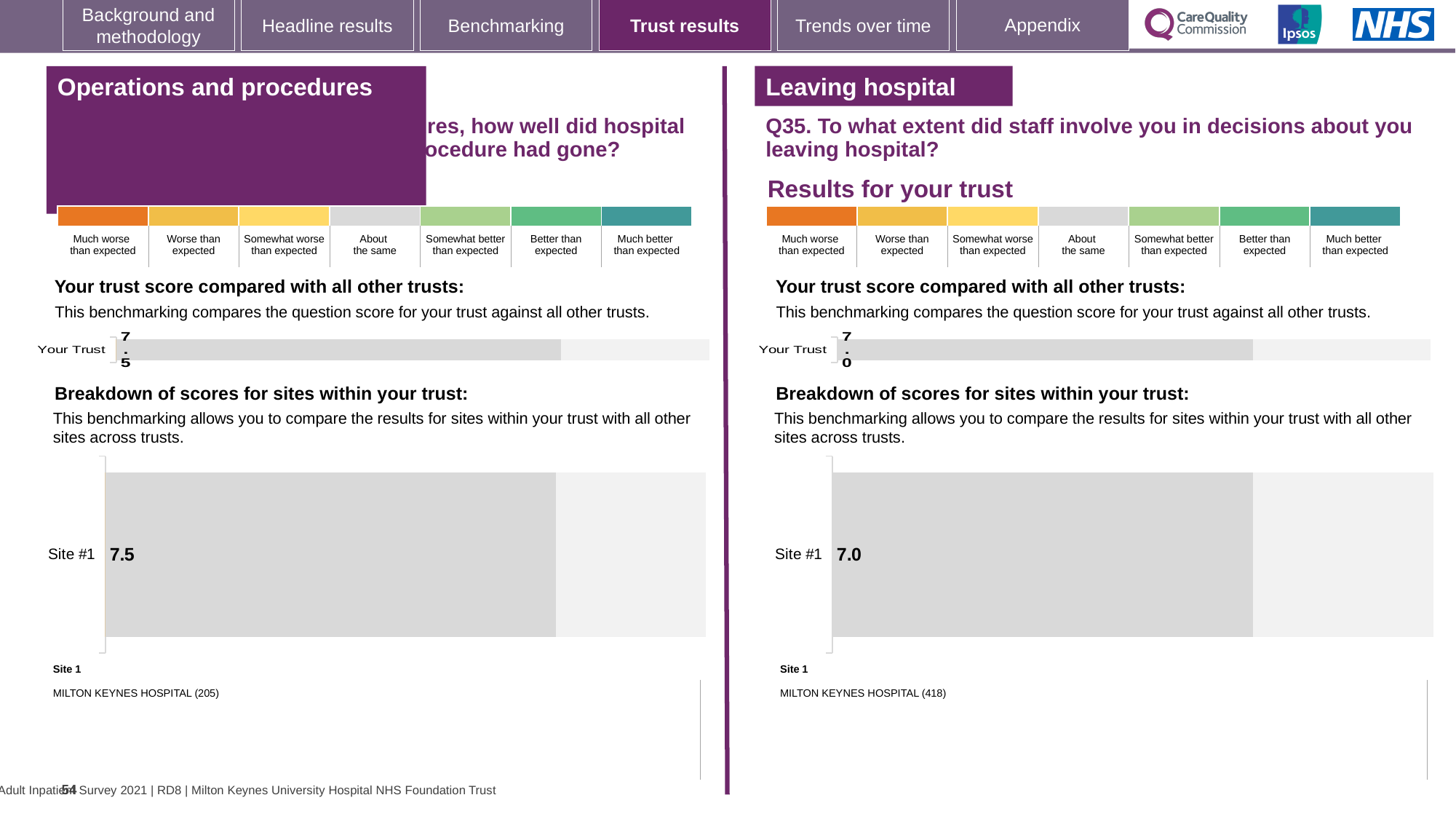
In the Operations and procedures section, which site is listed as Site 1 below the breakdown chart? MILTON KEYNES HOSPITAL (205) What type of chart is used to show the Site #1 score in the Leaving hospital section? Bar chart How many sites are shown in the breakdown of scores chart in the Operations and procedures section? 1 In the Operations and procedures section, what score is shown for Site #1 in the breakdown of scores for sites within your trust? 7.5 Which is larger: the Site #1 score in the Operations and procedures breakdown chart or the Site #1 score in the Leaving hospital breakdown chart? Operations and procedures (7.5) In the Leaving hospital section, which site is listed as Site 1 below the breakdown chart? MILTON KEYNES HOSPITAL (418) Is the Your Trust score in the Leaving hospital section greater or less than the Your Trust score in the Operations and procedures section? less How many sites are shown in the breakdown of scores chart in the Leaving hospital section? 1 In the Leaving hospital section, what is the score shown for Your Trust in the chart comparing your trust score with all other trusts? 7.0 In the Leaving hospital section, what score is shown for Site #1 in the breakdown of scores for sites within your trust? 7.0 What is the difference between the Your Trust score in the Operations and procedures section and the Your Trust score in the Leaving hospital section? 0.5 In the Operations and procedures section, what is the score shown for Your Trust in the chart comparing your trust score with all other trusts? 7.5